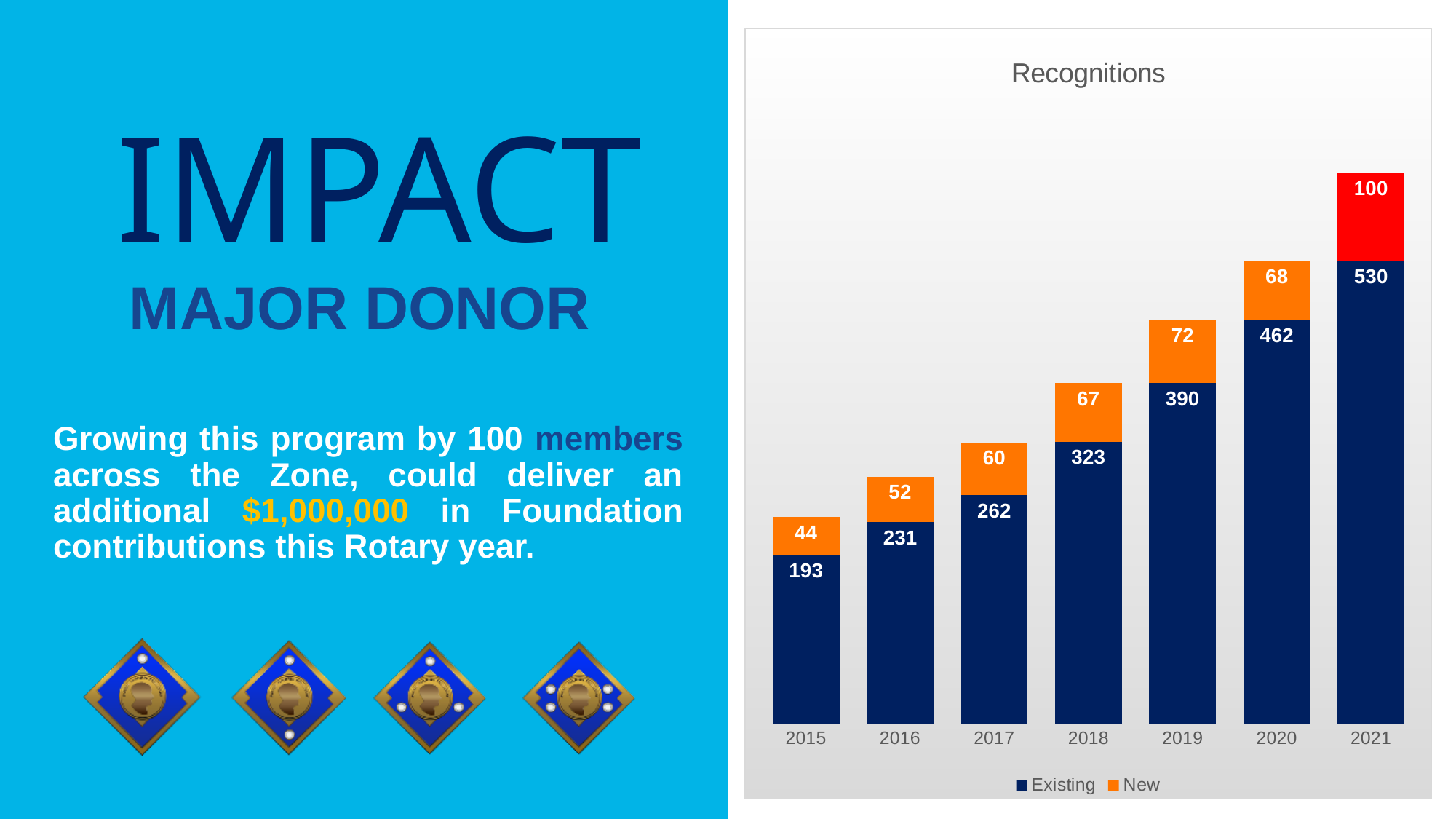
What is the difference between the Existing values for 2020 and 2019? 72 What is the New value for 2016 in the Recognitions chart? 52 Which year has the highest Existing value in the Recognitions chart? 2021 Is the New value for 2019 larger or smaller than the New value for 2020? larger How many years are shown on the x axis of the Recognitions chart? 7 Which year has the lowest New value in the Recognitions chart? 2015 What is the Existing value for 2018 in the Recognitions chart? 323 What kind of chart is the Recognitions chart? stacked bar chart Do the Existing values rise or fall from 2015 to 2021? rise What is the total of the stacked bar for 2021 in the Recognitions chart? 630 What is the title of the chart on the slide? Recognitions How many series does the legend of the Recognitions chart list? 2